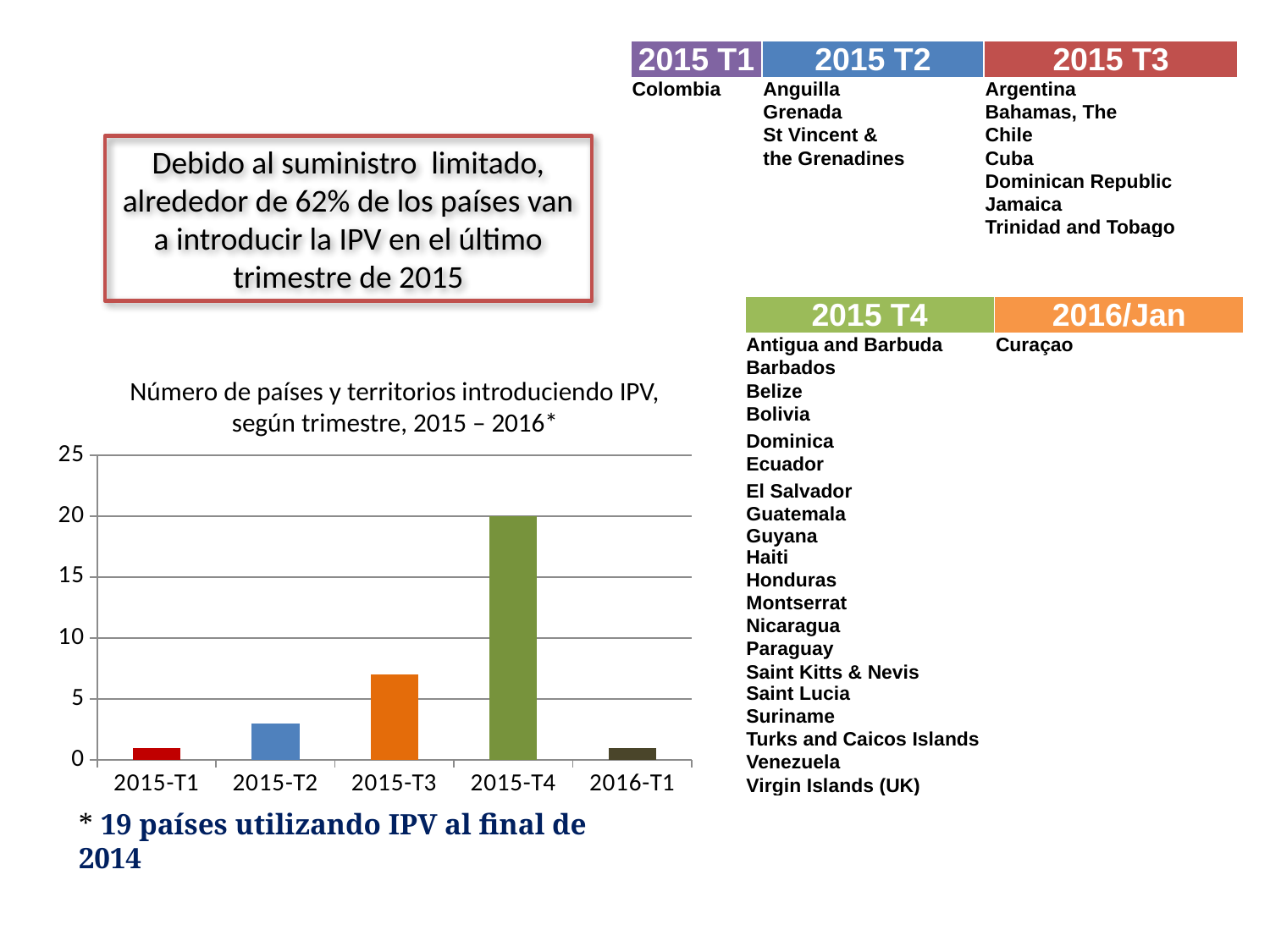
Is the value for 2015-T3 greater or less than 10? less What kind of chart is shown on the slide? bar chart What colour is the bar for 2015-T4? green How many quarters (categories) are shown on the x axis of the chart? 5 Do the values rise or fall from 2015-T1 to 2015-T4? rise Which is larger, the value for 2015-T3 or the value for 2015-T2? 2015-T3 What is the value for 2015-T4 in the chart? 20 Which quarter has the highest number of countries and territories introducing IPV? 2015-T4 Is the value for 2015-T1 greater or less than 5? less Is the value for 2015-T2 greater or less than 5? less What is the title of the chart? Número de países y territorios introduciendo IPV, según trimestre, 2015 – 2016*